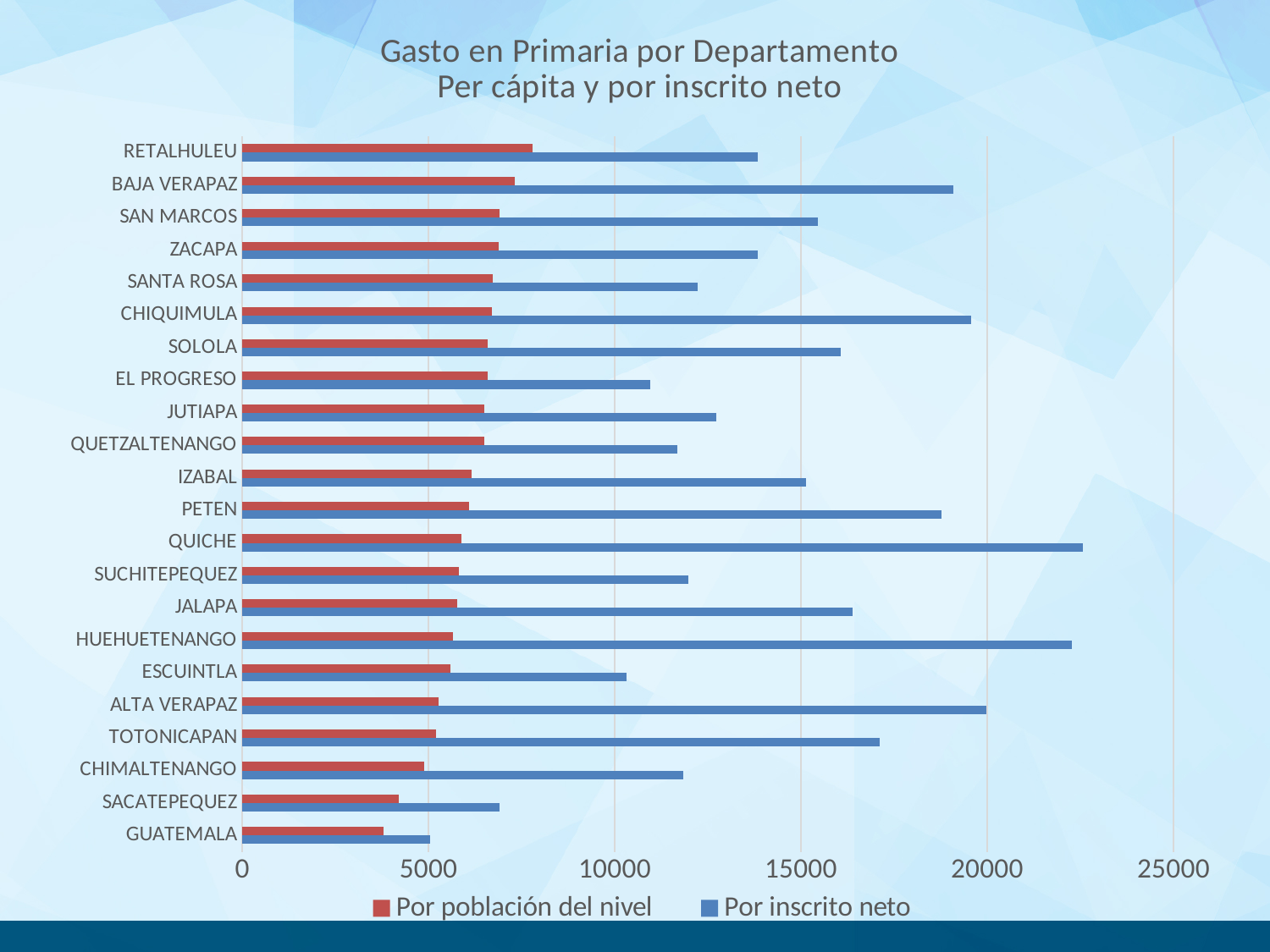
Is the 'Por inscrito neto' value for SACATEPEQUEZ greater or less than 5000? greater Which has the larger 'Por inscrito neto' value, BAJA VERAPAZ or SAN MARCOS? BAJA VERAPAZ Is the 'Por inscrito neto' value for QUICHE greater or less than 20000? greater What kind of chart is shown on the slide? bar chart Which has the larger 'Por inscrito neto' value, CHIQUIMULA or SANTA ROSA? CHIQUIMULA Which colour represents the 'Por inscrito neto' series? blue Is the 'Por población del nivel' value for RETALHULEU greater or less than 5000? greater Which department has the lowest value for 'Por inscrito neto'? GUATEMALA How many series does the legend list? 2 Which department has the highest value for 'Por población del nivel'? RETALHULEU Which department has the lowest value for 'Por población del nivel'? GUATEMALA How many departments are plotted on the chart? 22